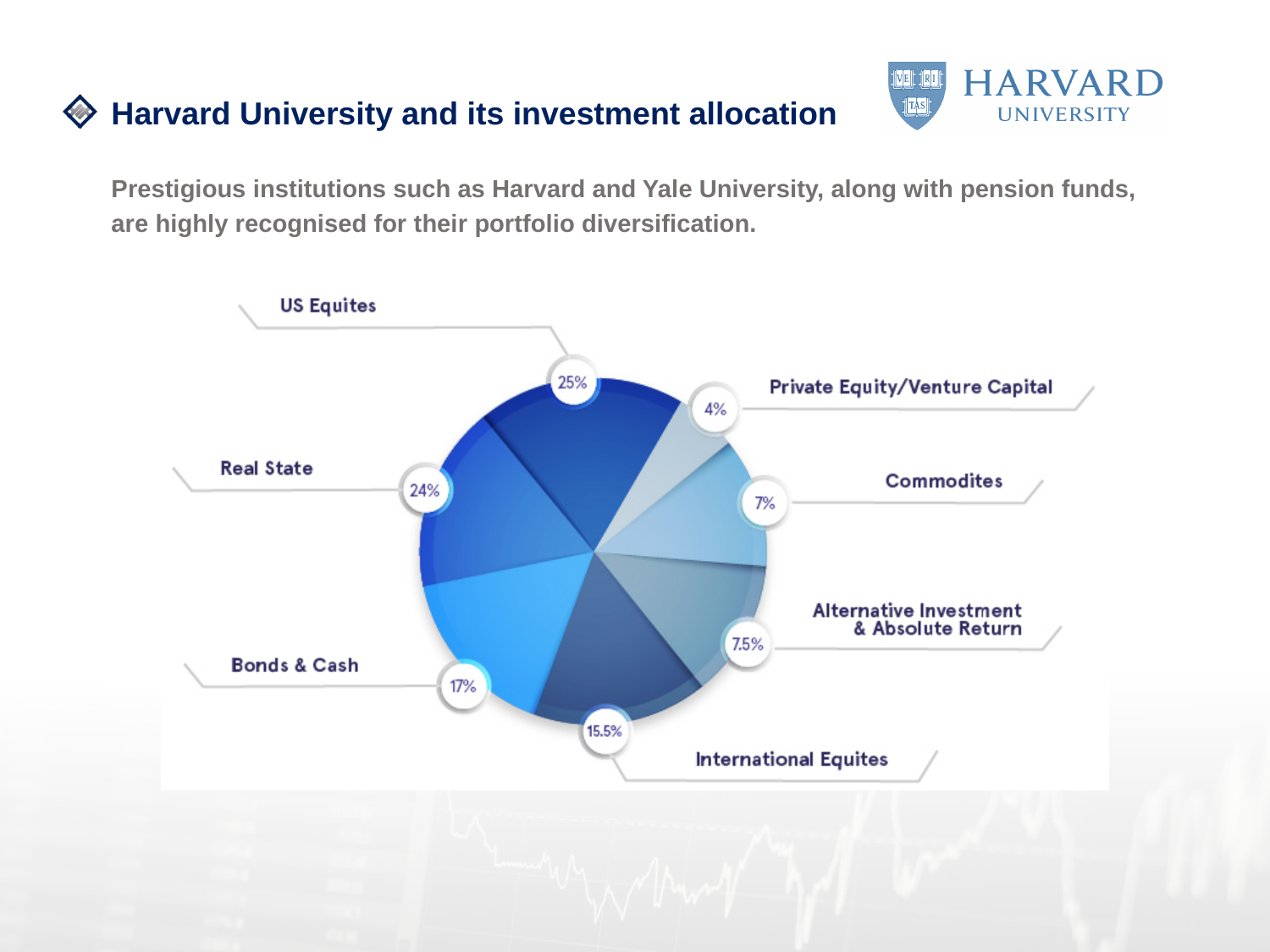
What percentage is allocated to Commodites? 7% Which is larger, the allocation to Bonds & Cash or to International Equites? Bonds & Cash Which category has the largest allocation? US Equites What is the allocation for Real State? 24% How many categories are shown in the pie chart? 7 What is the allocation for Alternative Investment & Absolute Return? 7.5% What percentage is allocated to International Equites? 15.5% What kind of chart is shown on the slide? Pie chart What share of the pie is Bonds & Cash? 17% What percentage of the portfolio is allocated to US Equites? 25% Which category has the smallest allocation? Private Equity/Venture Capital What is the difference between the US Equites and Real State allocations? 1%